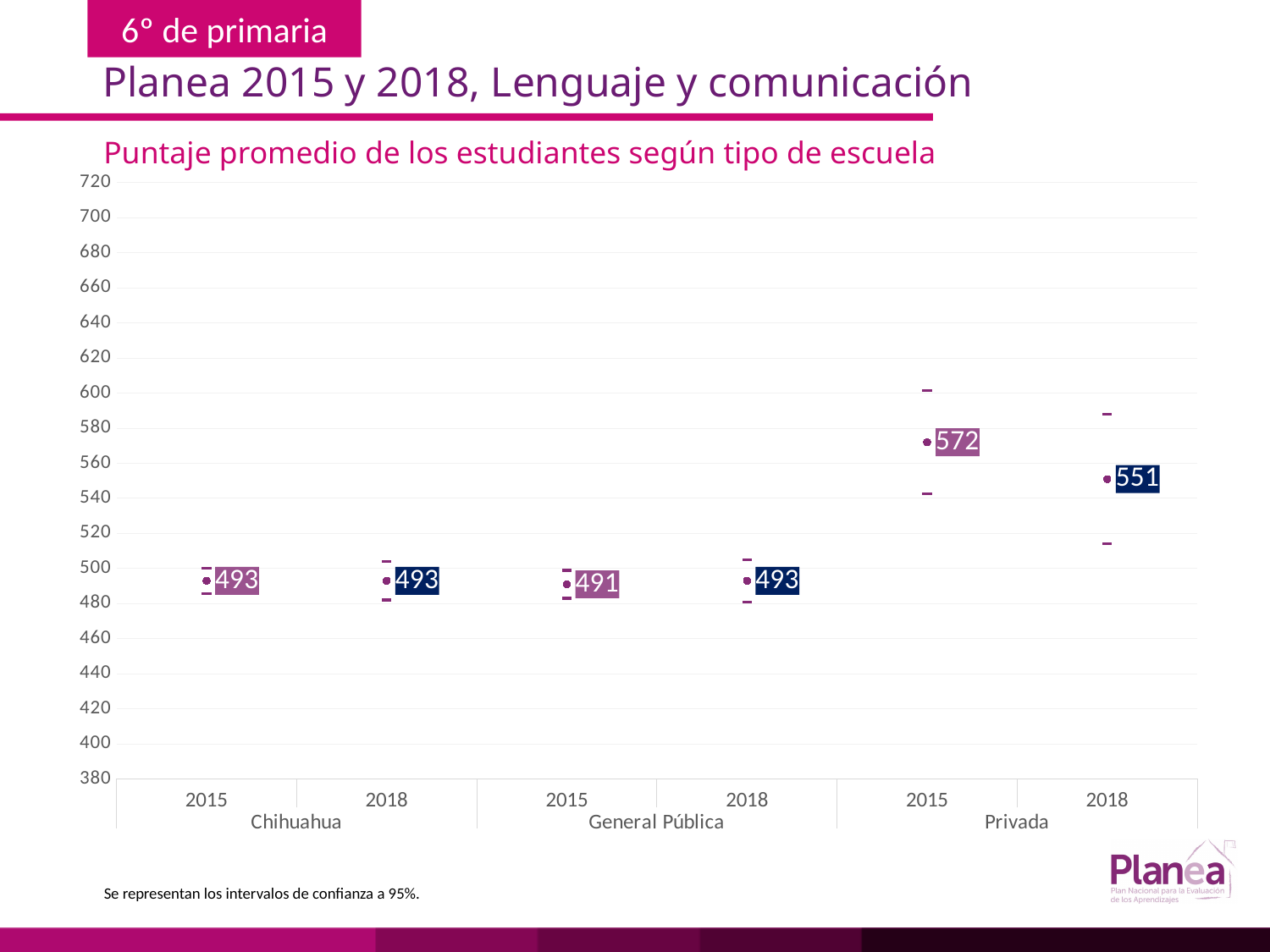
What is the average score for Privada in 2015? 572 What is the average score for Chihuahua in 2015? 493 Which is larger, the Privada 2015 score or the Privada 2018 score? Privada 2015 What is the difference between the Privada 2018 score and the Chihuahua 2018 score? 58 What is the average score for Privada in 2018? 551 What is the average score for General Pública in 2015? 491 Which school type and year has the lowest average score? General Pública 2015 Which school type and year has the highest average score? Privada 2015 Did the Privada average score rise or fall from 2015 to 2018? fall What is the difference between the Privada scores in 2015 and 2018? 21 What is the title of the chart? Puntaje promedio de los estudiantes según tipo de escuela